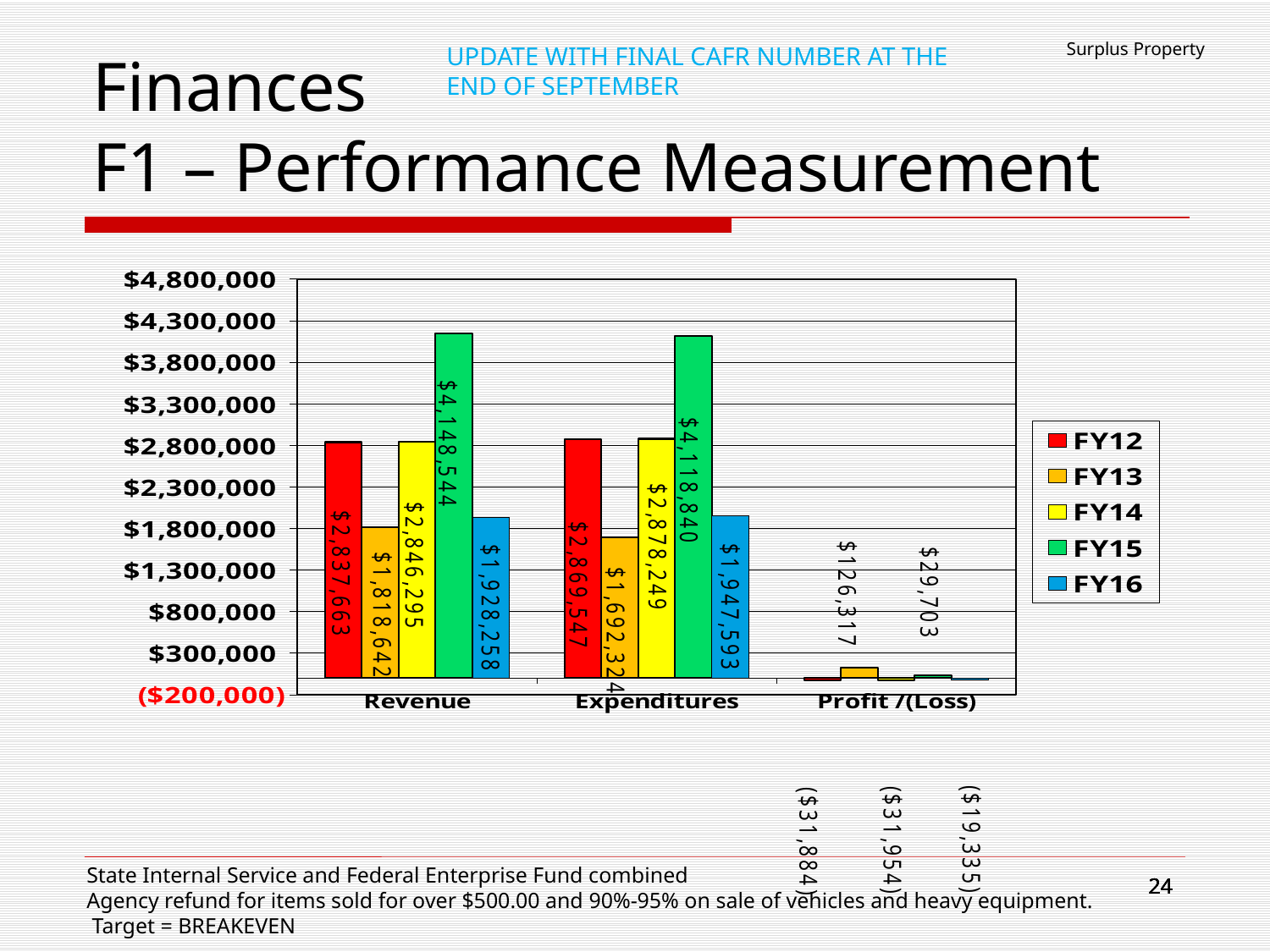
Which is larger, FY14 Expenditures or FY12 Expenditures? FY14 Expenditures What is the difference between the FY14 and FY12 Revenue values? $8,632 Which fiscal year has the lowest Expenditures? FY13 What is the FY16 value for Revenue? $1,928,258 How many series does the legend list? 5 Which fiscal year has the highest Revenue? FY15 What kind of chart is shown on the slide? bar chart How many categories are shown on the x axis? 3 What is the FY13 value for Profit /(Loss)? $126,317 Is the FY15 Expenditures value greater or less than $3,800,000? greater What is the FY13 value for Expenditures? $1,692,324 What is the FY15 value for Revenue? $4,148,544